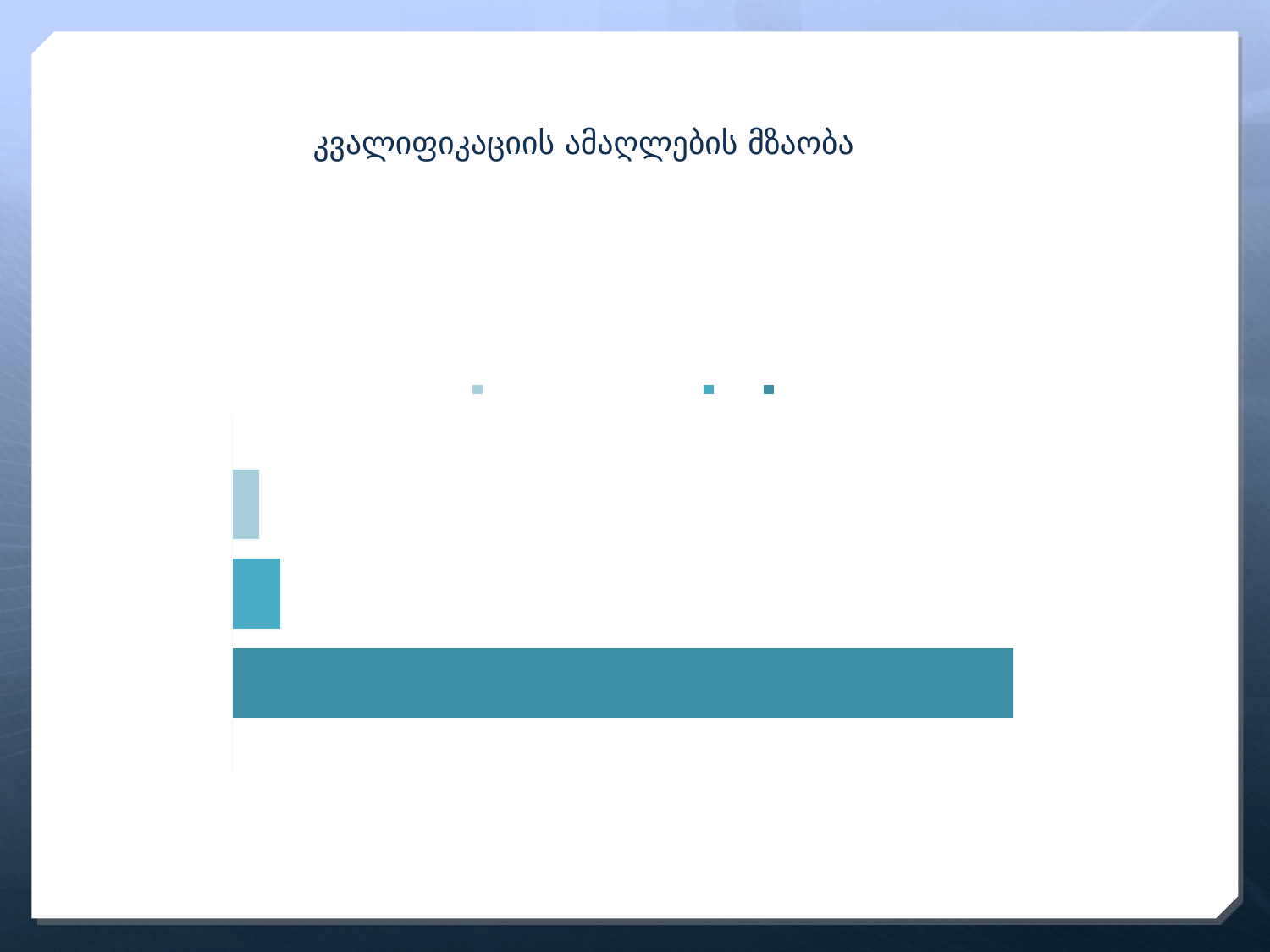
Which bar is the longest: the top, middle, or bottom bar? bottom Are the bars in the chart horizontal or vertical? horizontal How many legend markers are shown above the chart? 3 What kind of chart is shown on the slide? bar chart Is the bottom bar longer or shorter than the middle bar? longer Is the top bar longer or shorter than the middle bar? shorter What is the title shown above the chart on the slide? კვალიფიკაციის ამაღლების მზაობა How many bars are plotted in the chart? 3 Which bar is the shortest: the top, middle, or bottom bar? top